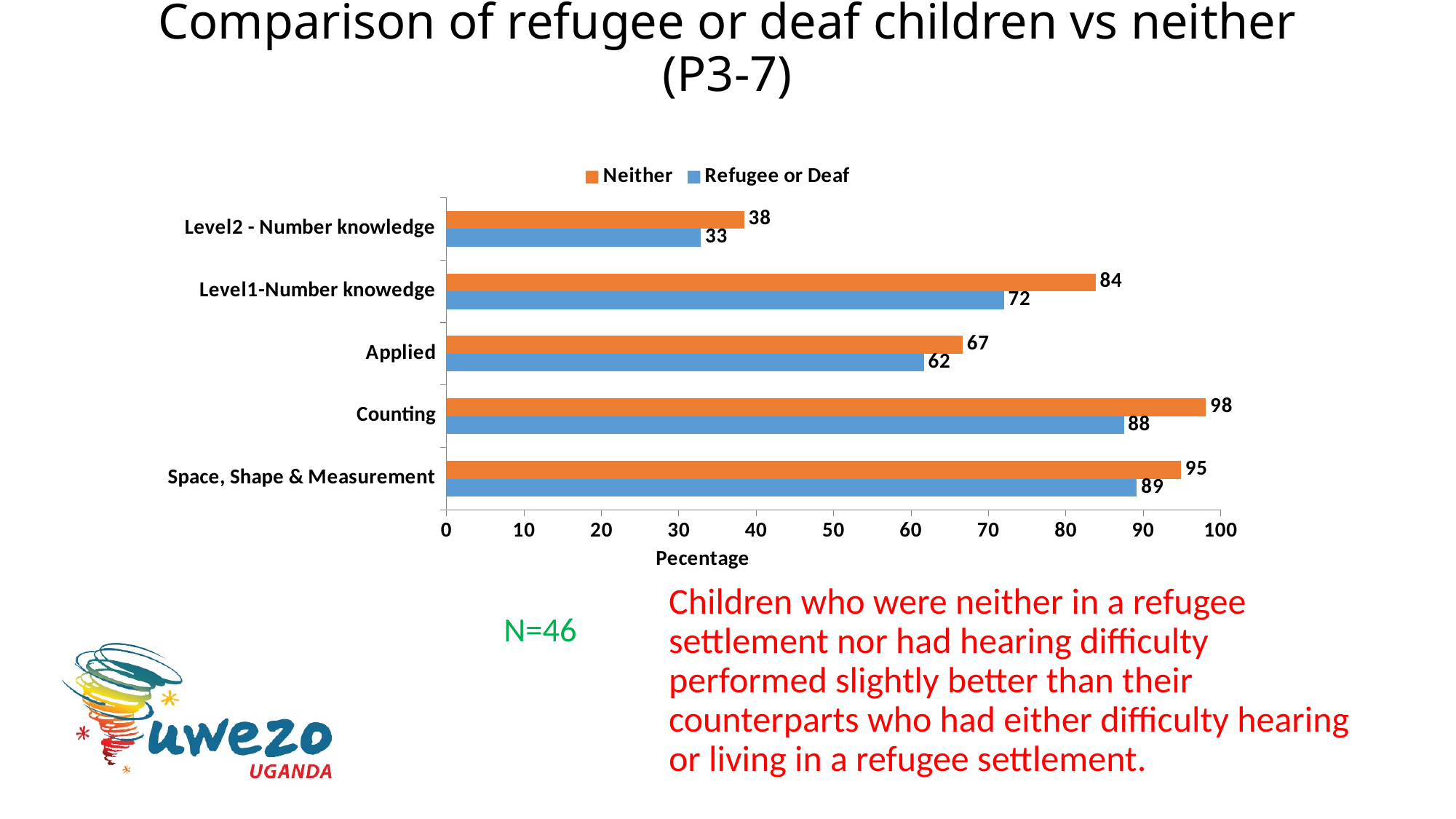
What is the difference between the Neither and Refugee or Deaf values for Level1-Number knowedge? 12 How many categories are shown on the chart? 5 What is the value for Refugee or Deaf in the Space, Shape & Measurement category? 89 What is the value for Refugee or Deaf in the Level1-Number knowedge category? 72 What kind of chart is shown on the slide? Bar chart How many series does the legend list? 2 Which category has the highest value for the Neither series? Counting What is the difference between the Neither and Refugee or Deaf values for Counting? 10 Which category has the lowest value for the Refugee or Deaf series? Level2 - Number knowledge Which is larger for the Applied category: the Neither value or the Refugee or Deaf value? Neither What is the label of the horizontal axis? Pecentage What is the value for Neither in the Counting category? 98